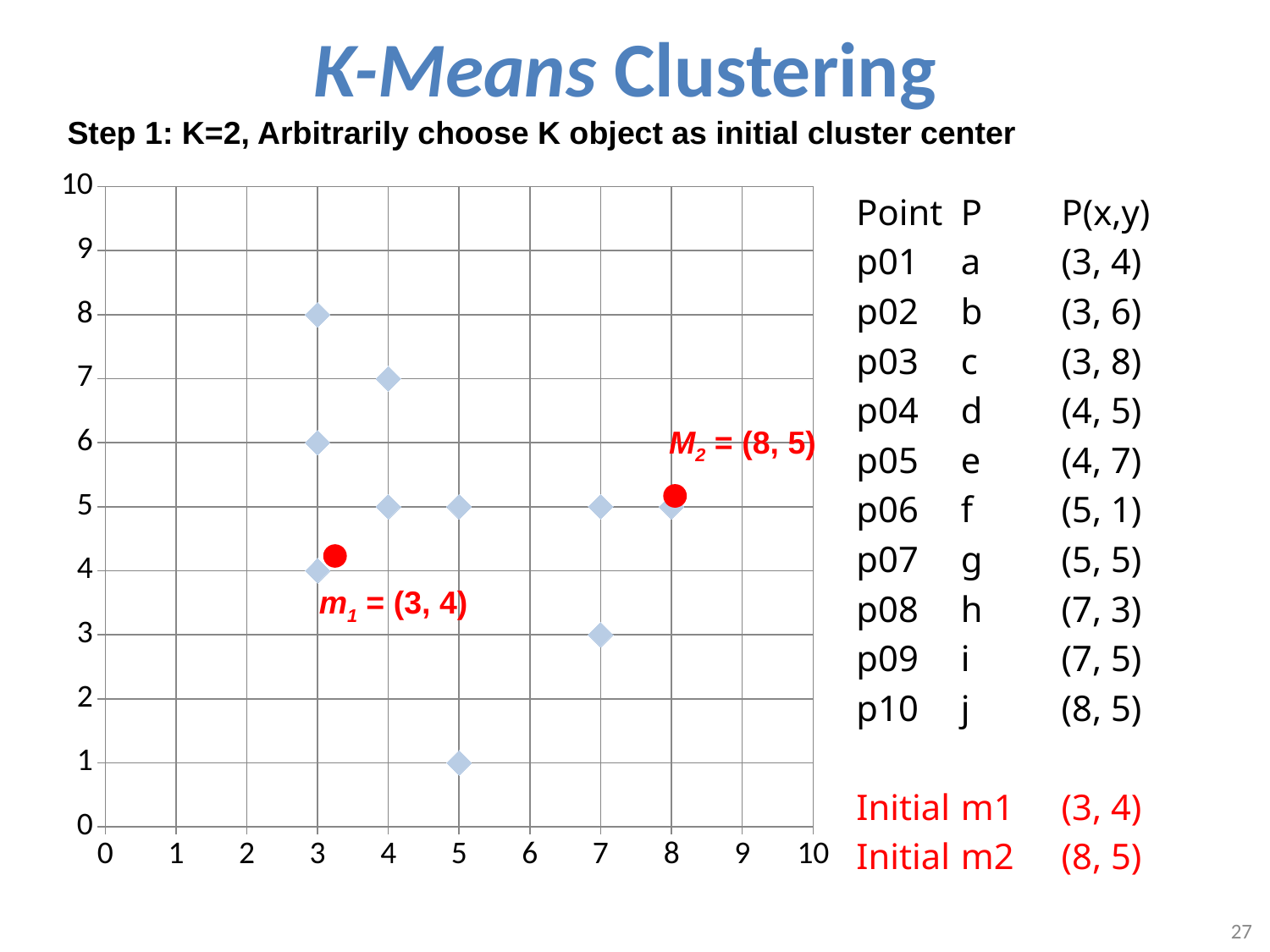
How many plotted points lie on the line y = 5? 4 How many data points (p01 to p10) are plotted on the chart? 10 What is the difference in y value between point c (3, 8) and point a (3, 4)? 4 Which point has the lowest y value? f (5, 1) Which point has the highest y value? c (3, 8) Which has a larger y value, point e (4, 7) or point h (7, 3)? point e What are the coordinates of the initial cluster center m1? (3, 4) What kind of chart is shown on the slide? scatter chart What are the coordinates of the initial cluster center M2? (8, 5) Which point has the largest x value? j (8, 5) What are the coordinates of point c (p03)? (3, 8) What are the coordinates of point f (p06)? (5, 1)